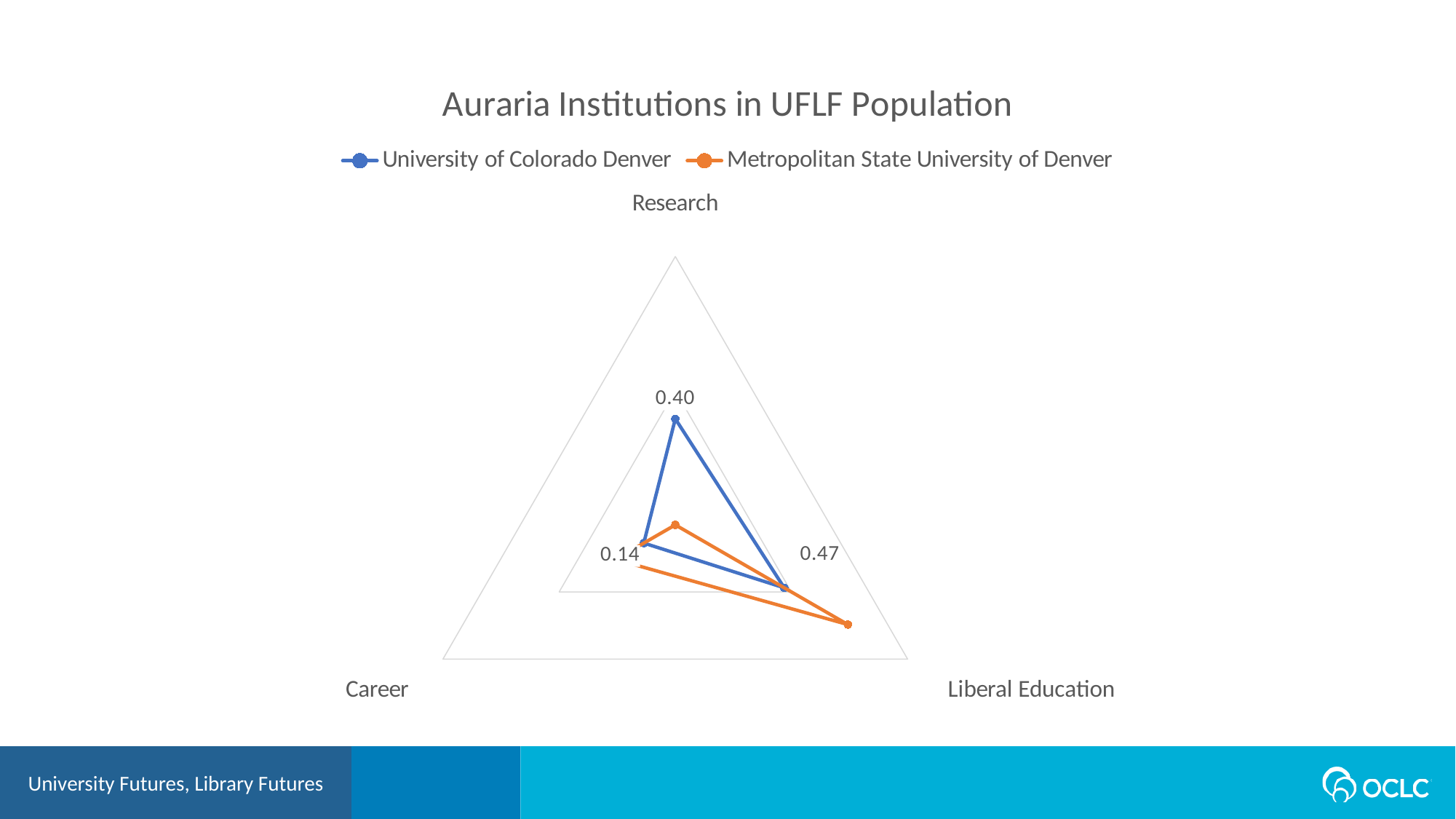
What kind of chart is shown on the slide? Radar chart On which axis does University of Colorado Denver have its lowest value? Career What is the Career value for University of Colorado Denver? 0.14 What is the Research value for University of Colorado Denver? 0.40 How many series does the legend list? 2 Which institution has the higher Liberal Education value? Metropolitan State University of Denver What is the Liberal Education value for University of Colorado Denver? 0.47 On which axis does University of Colorado Denver have its highest value? Liberal Education Which institution has the higher Research value? University of Colorado Denver What is the difference between University of Colorado Denver's Liberal Education and Research values? 0.07 What is the difference between University of Colorado Denver's Research and Career values? 0.26 How many axes (categories) does the chart have? 3